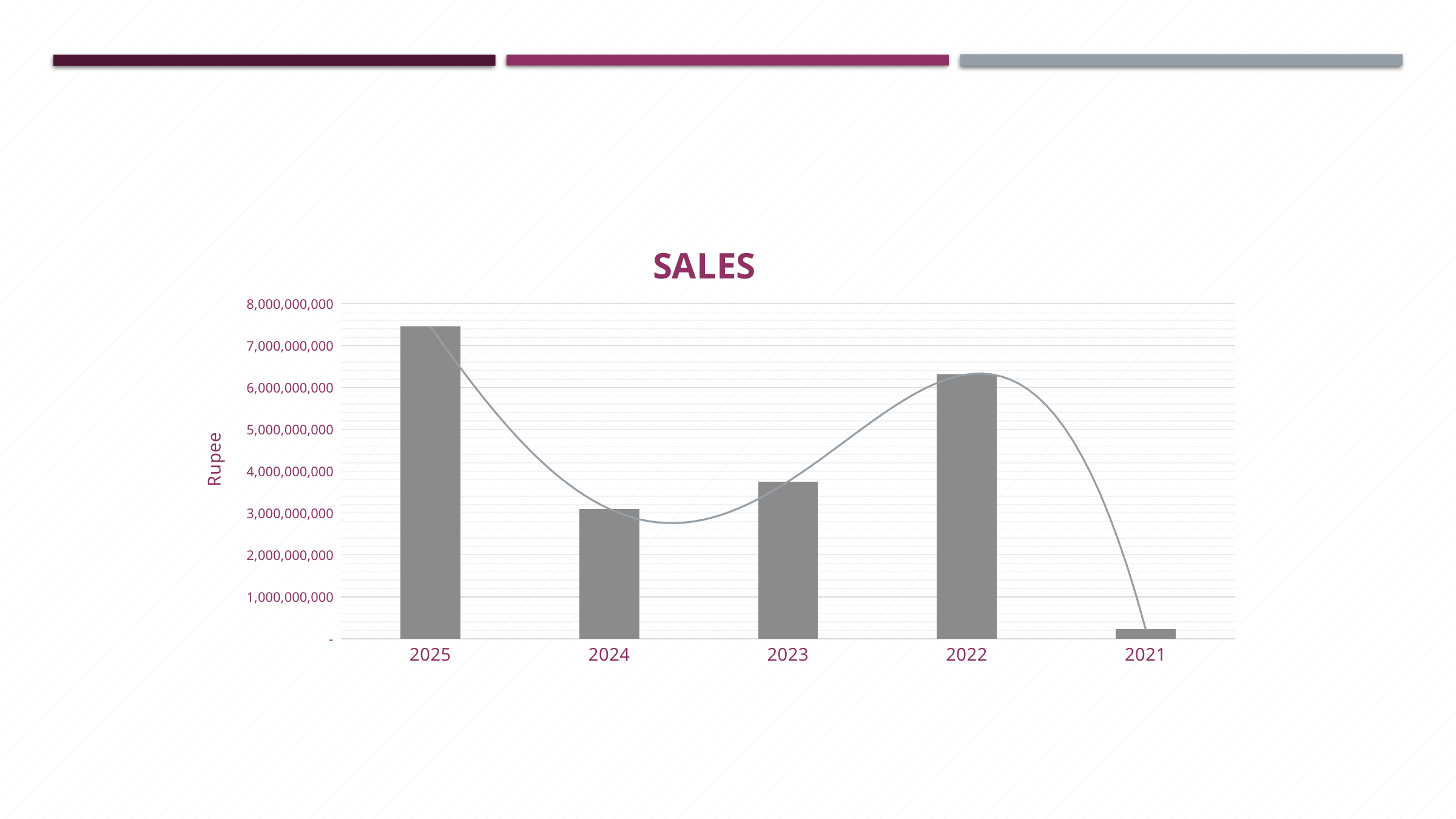
Is the sales value for 2021 greater or less than 1,000,000,000? less Which year has the lowest sales value? 2021 Which year has the highest sales value? 2025 Is the sales value for 2022 greater or less than 6,000,000,000? greater What kind of chart is shown on the slide? bar chart Which year has higher sales, 2024 or 2023? 2023 Is the sales value for 2024 greater or less than 4,000,000,000? less How many years are shown on the x axis of the chart? 5 Which year has higher sales, 2022 or 2025? 2025 What is the label on the vertical axis of the chart? Rupee What is the title of the chart? SALES